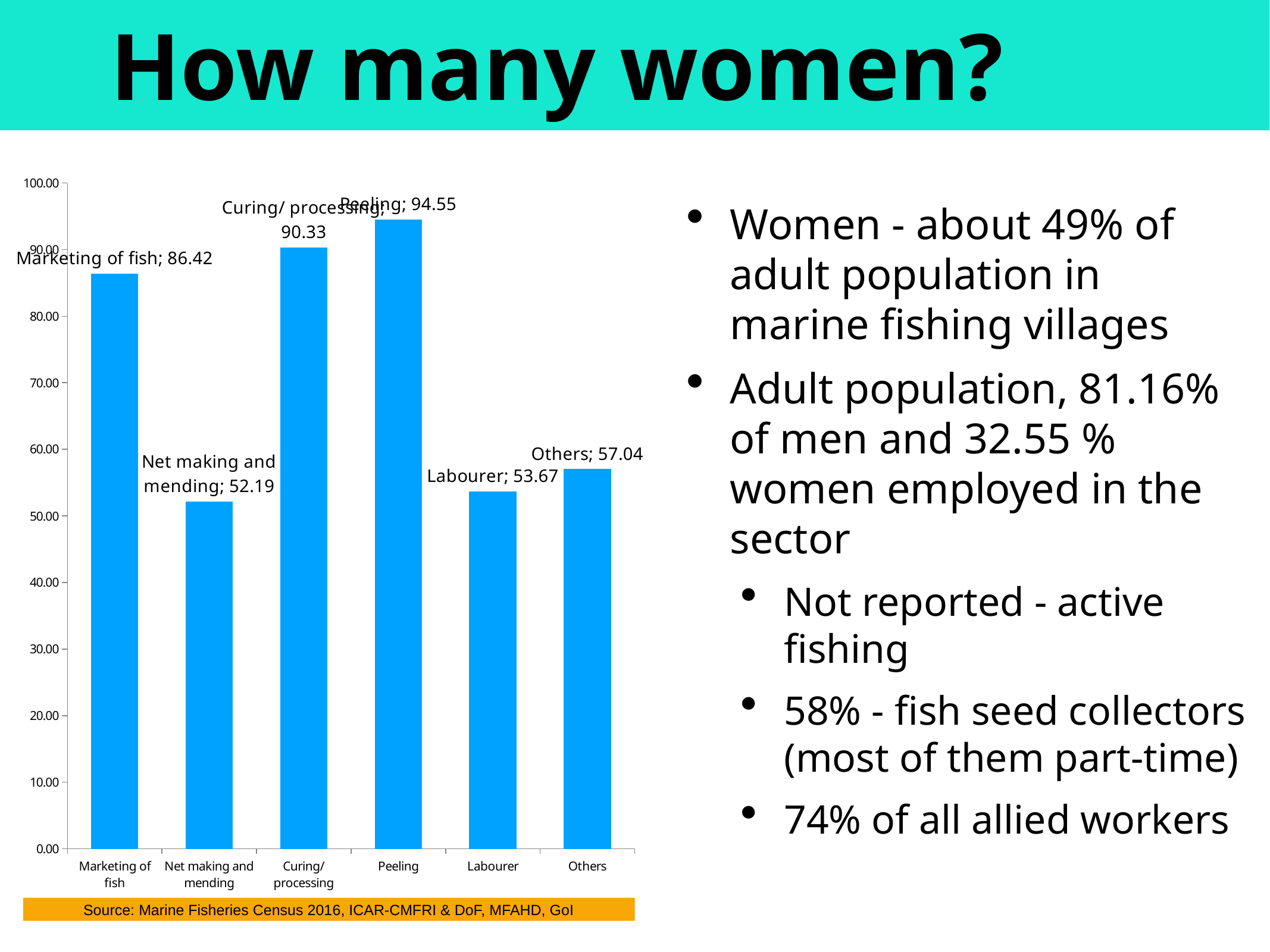
Is the value for Curing/ processing greater or less than 80.00? greater What is the value for Labourer? 53.67 Which category has the lowest value? Net making and mending What is the difference between the values for Peeling and Curing/ processing? 4.22 Which is larger, the value for Marketing of fish or the value for Others? Marketing of fish What is the difference between the values for Others and Labourer? 3.37 What is the value for Net making and mending? 52.19 What is the value for Marketing of fish? 86.42 How many categories are shown on the x axis? 6 Which category has the highest value? Peeling What kind of chart is shown on the slide? bar chart What is the value for Peeling? 94.55